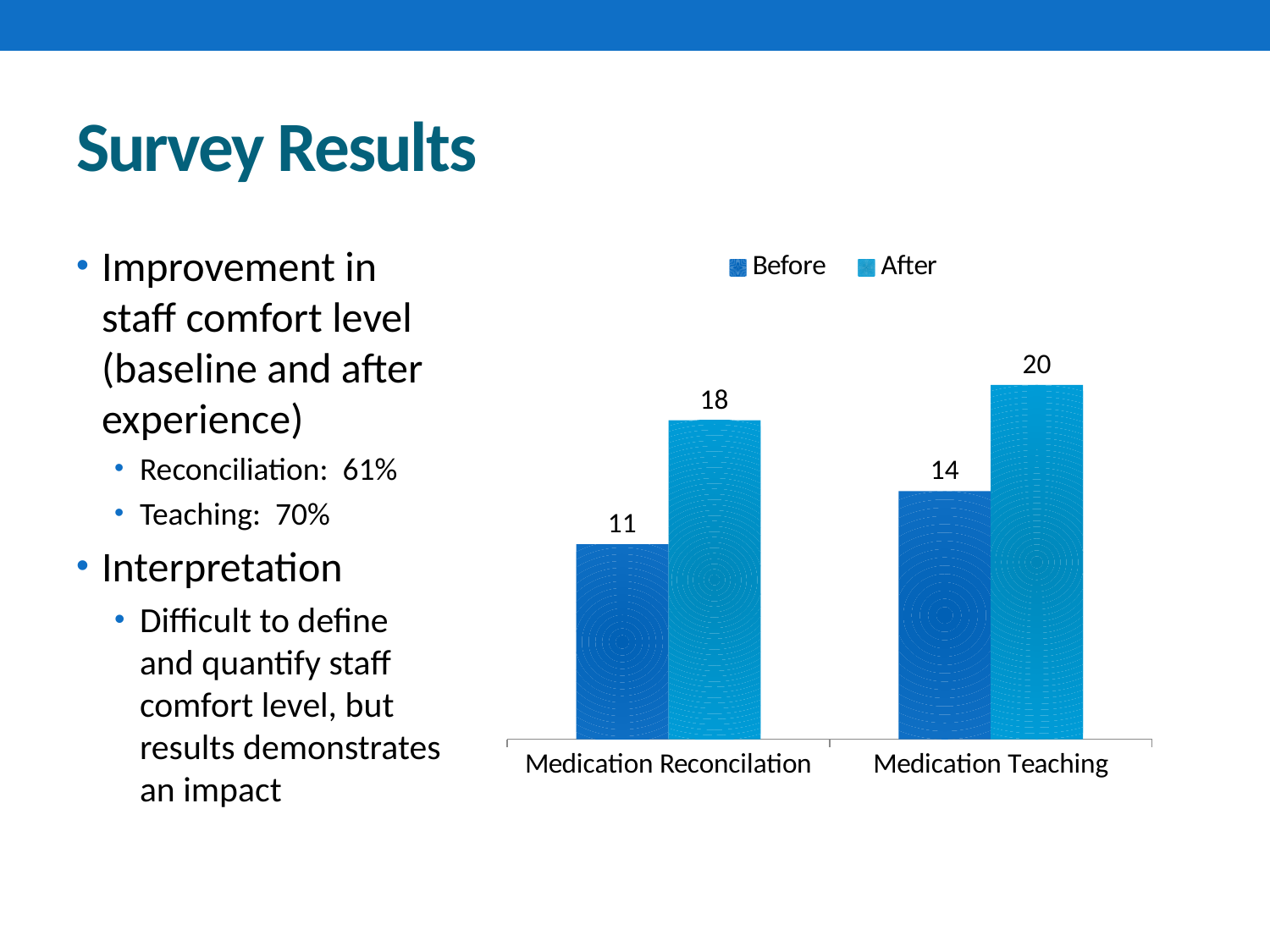
Which category has the highest After value? Medication Teaching Which is larger for Medication Teaching, the Before value or the After value? After What is the Before value for Medication Teaching? 14 Which category has the lowest Before value? Medication Reconcilation How many series does the chart legend list? 2 What is the After value for Medication Reconcilation? 18 What is the difference between the After and Before values for Medication Reconcilation? 7 How many categories are shown on the x axis of the chart? 2 What kind of chart is shown on the slide? Bar chart What is the After value for Medication Teaching? 20 What is the difference between the After and Before values for Medication Teaching? 6 What is the Before value for Medication Reconcilation? 11